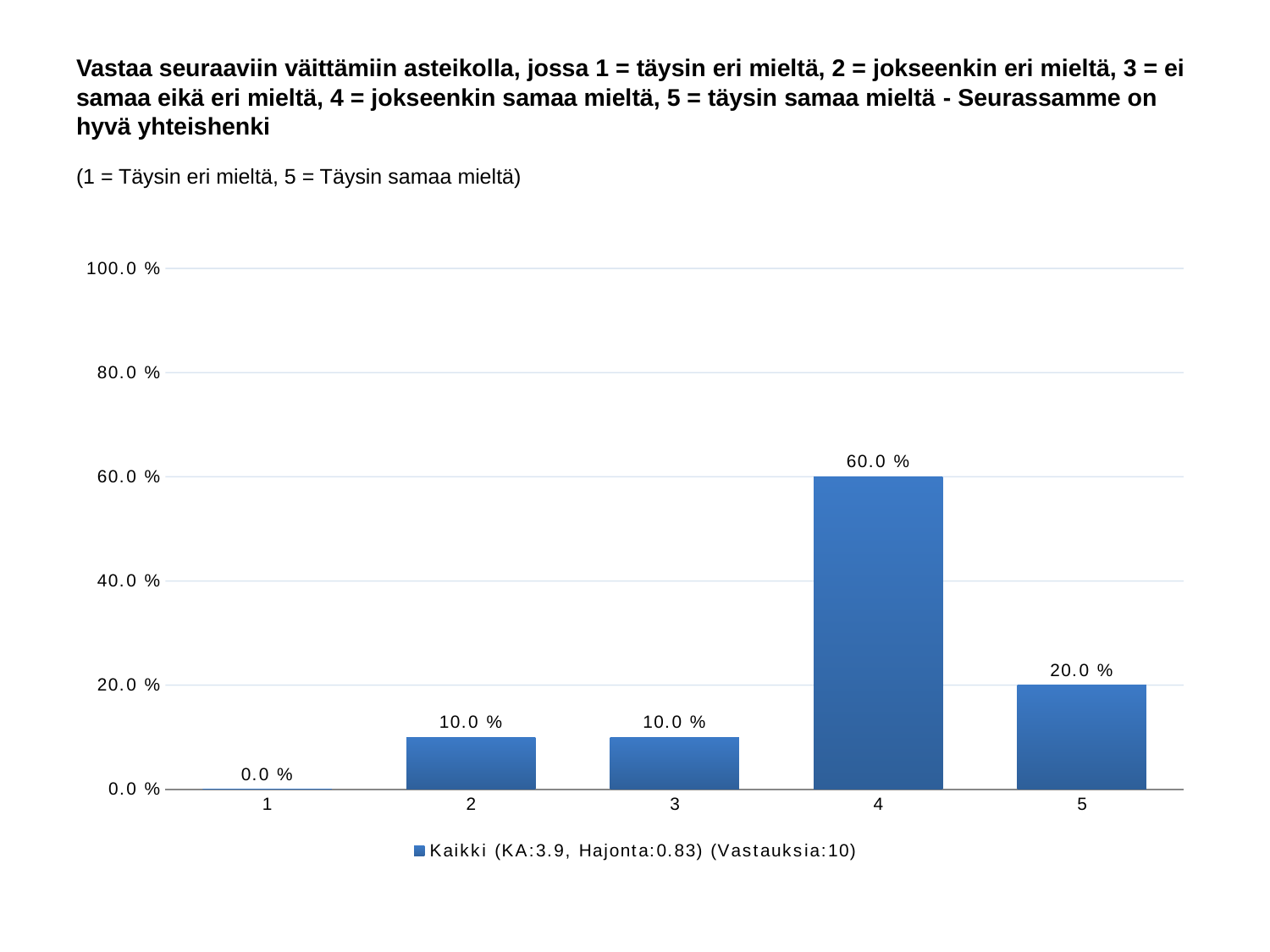
Which is larger, the value for category 5 or the value for category 3? 5 What is the difference between the values for category 4 and category 5? 40.0 % What is the value for category 2? 10.0 % Which category has the lowest value? 1 What kind of chart is shown on the slide? bar chart How many responses (Vastauksia) does the legend entry report? 10 Which category has the highest value? 4 What is the value for category 1? 0.0 % Is the value for category 4 greater or less than 40.0 %? greater What is the value for category 5? 20.0 % How many categories are shown on the x axis? 5 What is the value for category 4? 60.0 %